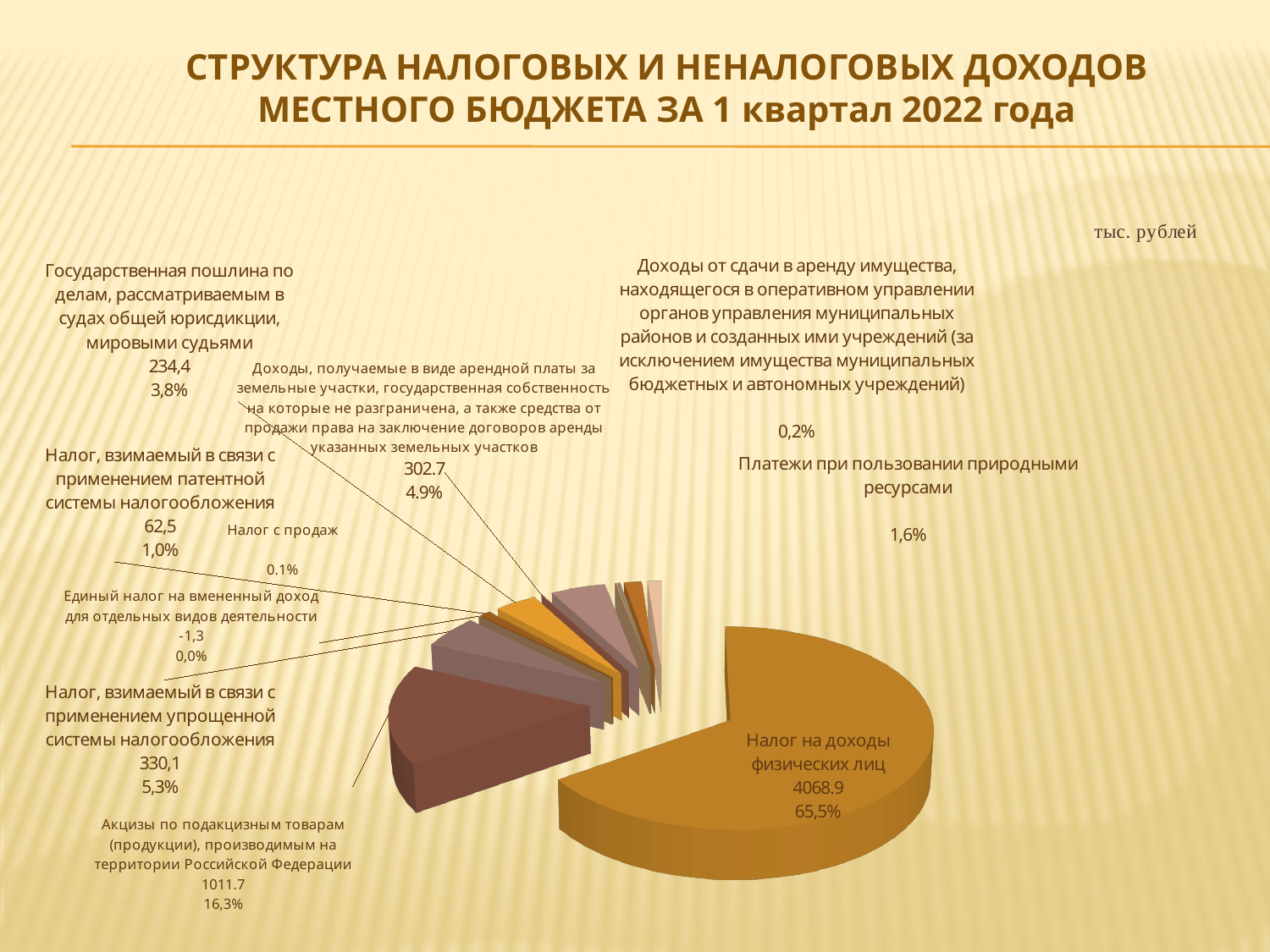
What is the value for Акцизы по подакцизным товарам (продукции), производимым на территории Российской Федерации? 1011.7 What type of chart is shown on the slide? pie chart What share of the pie does Платежи при пользовании природными ресурсами represent? 1,6% What is the value for Налог на доходы физических лиц? 4068.9 What share of the pie does Налог, взимаемый в связи с применением упрощенной системы налогообложения represent? 5,3% What is the value for Государственная пошлина по делам, рассматриваемым в судах общей юрисдикции, мировыми судьями? 234,4 What is the difference between the values for Налог на доходы физических лиц and Акцизы по подакцизным товарам? 3057.2 In what units are the values on the chart given? тыс. рублей Which category has the smallest share of the pie? Единый налог на вмененный доход для отдельных видов деятельности What share of the pie does Налог на доходы физических лиц represent? 65,5% Which category has the largest share of the pie? Налог на доходы физических лиц Which is larger: the value for Налог, взимаемый в связи с применением упрощенной системы налогообложения or the value for Доходы, получаемые в виде арендной платы за земельные участки? Налог, взимаемый в связи с применением упрощенной системы налогообложения